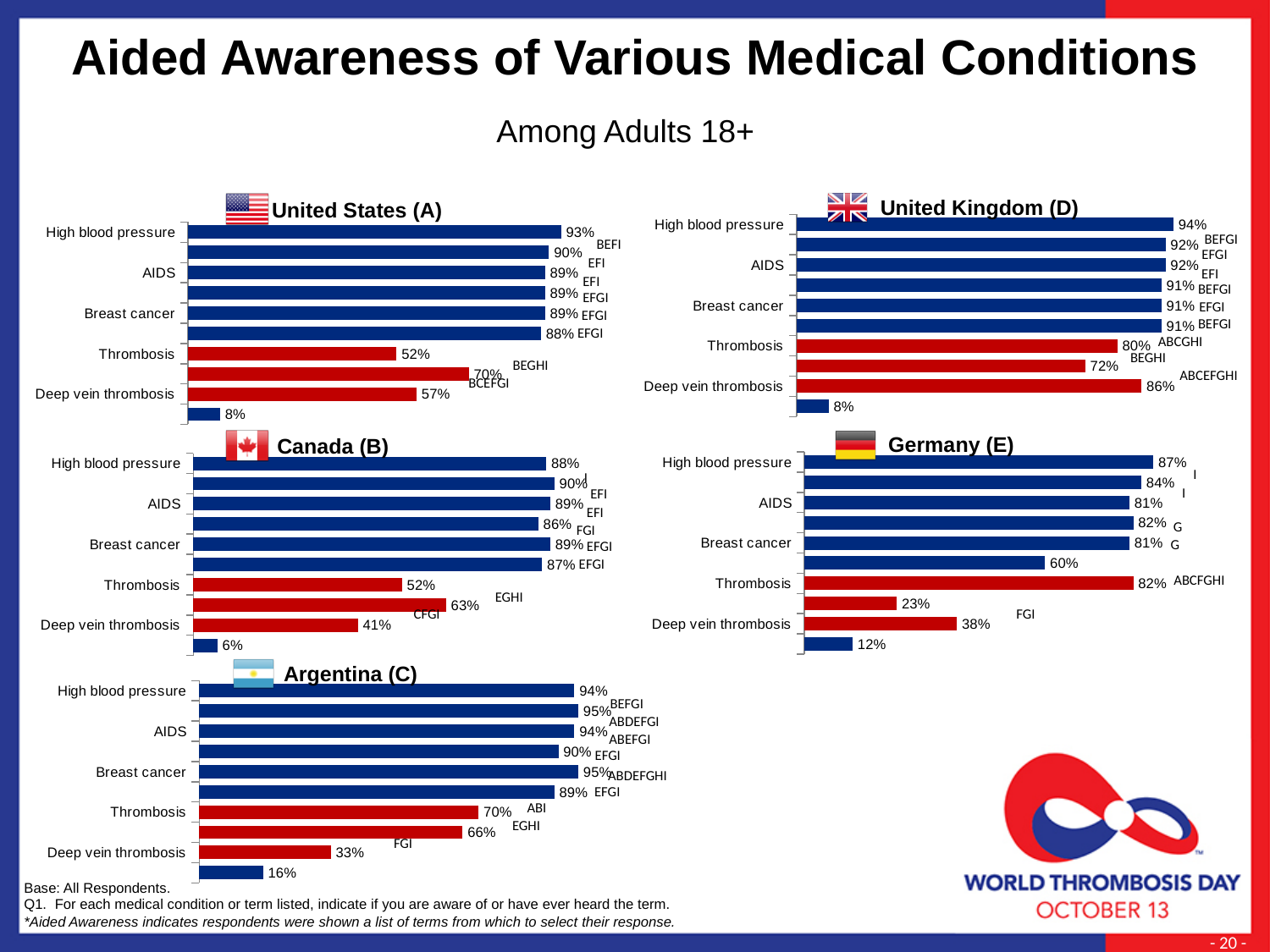
In the Argentina (C) chart, what is the difference between the values for Thrombosis and Deep vein thrombosis? 37 percentage points In the Germany (E) chart, which is larger, the value for Thrombosis or the value for Deep vein thrombosis? Thrombosis How many country charts are shown on the slide? 5 In the Argentina (C) chart, what is the lowest value shown? 16% In the United States (A) chart, what is the difference between the values for Deep vein thrombosis and Thrombosis? 5 percentage points Which chart shows a higher value for Thrombosis, United Kingdom (D) or Canada (B)? United Kingdom (D) In the United States (A) chart, what is the value for High blood pressure? 93% In the Argentina (C) chart, what is the value for Deep vein thrombosis? 33% What kind of chart is used for each country on this slide? Bar chart In the Canada (B) chart, what is the value for Thrombosis? 52% In the United Kingdom (D) chart, what is the value for Deep vein thrombosis? 86% In the Germany (E) chart, what is the value for Thrombosis? 82%